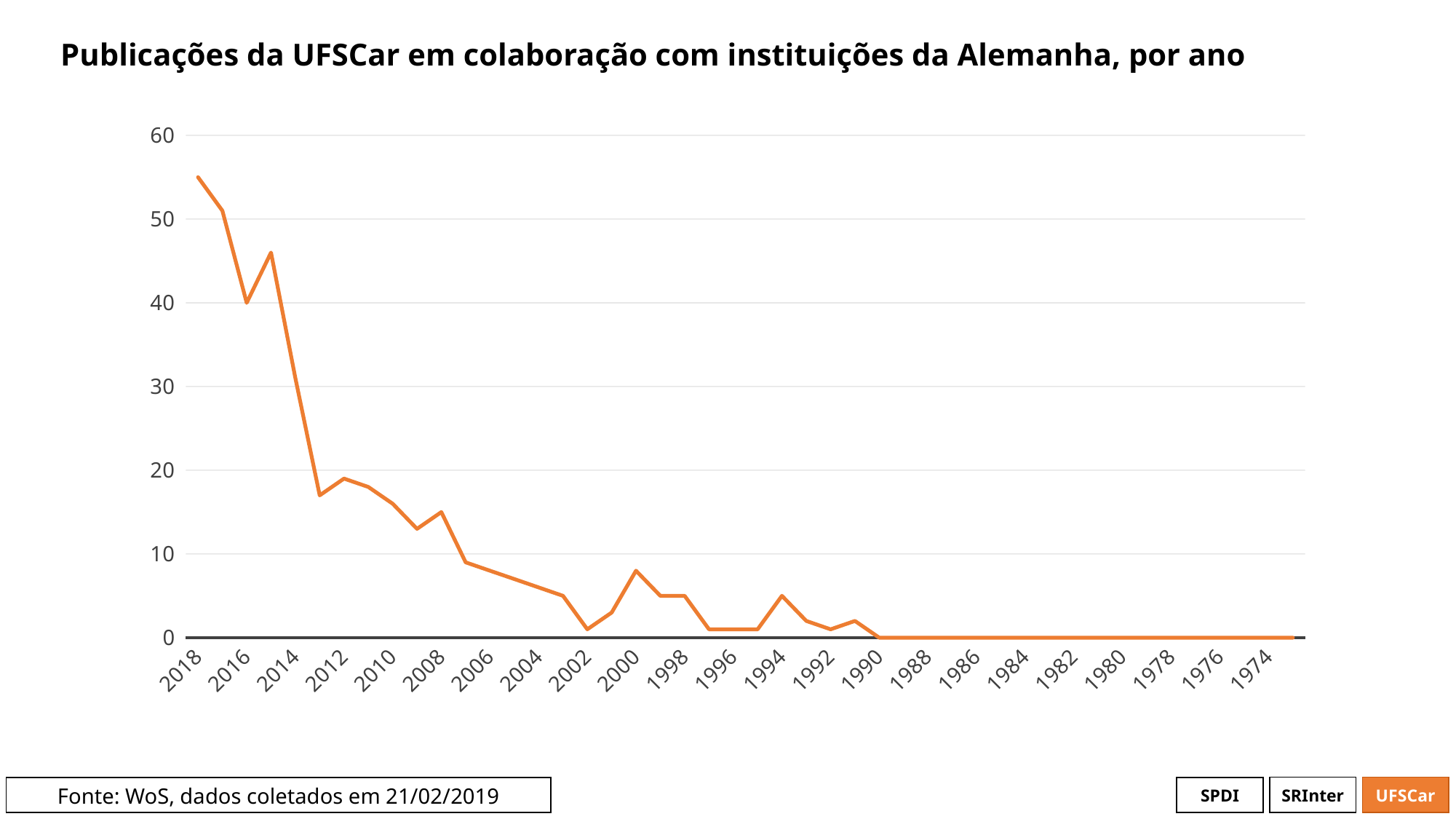
Is the value for 2008 greater or less than 10? greater Which is larger, the value for 2012 or the value for 2008? 2012 What kind of chart is shown on the slide? line chart Is the value for 2018 greater or less than 50? greater What is the title of the chart? Publicações da UFSCar em colaboração com instituições da Alemanha, por ano Is the value for 2014 greater or less than 40? less What is the value for 1986? 0 Which year has the highest number of publications? 2018 Which is larger, the value for 2018 or the value for 2016? 2018 Moving from left to right along the x axis (from 2018 toward 1974), do the values generally rise or fall? fall